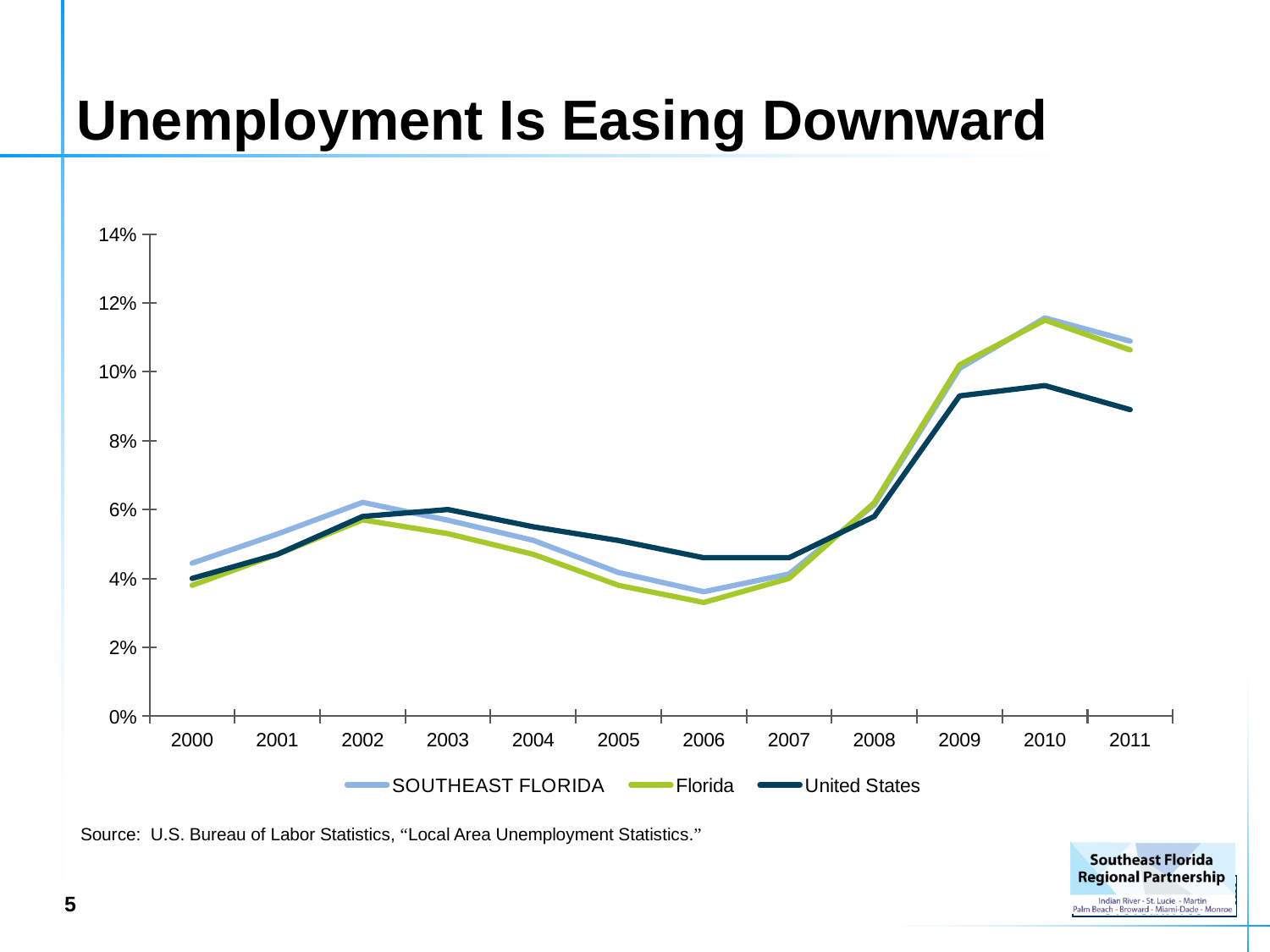
In which year is the Florida unemployment rate highest? 2010 In 2011, which is larger: the value for Florida or the value for United States? Florida Is the value for Florida in 2006 greater or less than 4%? less What is the title of the slide containing the chart? Unemployment Is Easing Downward Is the value for SOUTHEAST FLORIDA in 2010 greater or less than 10%? greater What kind of chart is shown on the slide? Line chart In which year is the Florida unemployment rate lowest? 2006 How many years are shown along the x axis? 12 Is the value for United States in 2010 greater or less than 8%? greater Do the values for SOUTHEAST FLORIDA rise or fall from 2006 to 2010? rise How many series does the legend list? 3